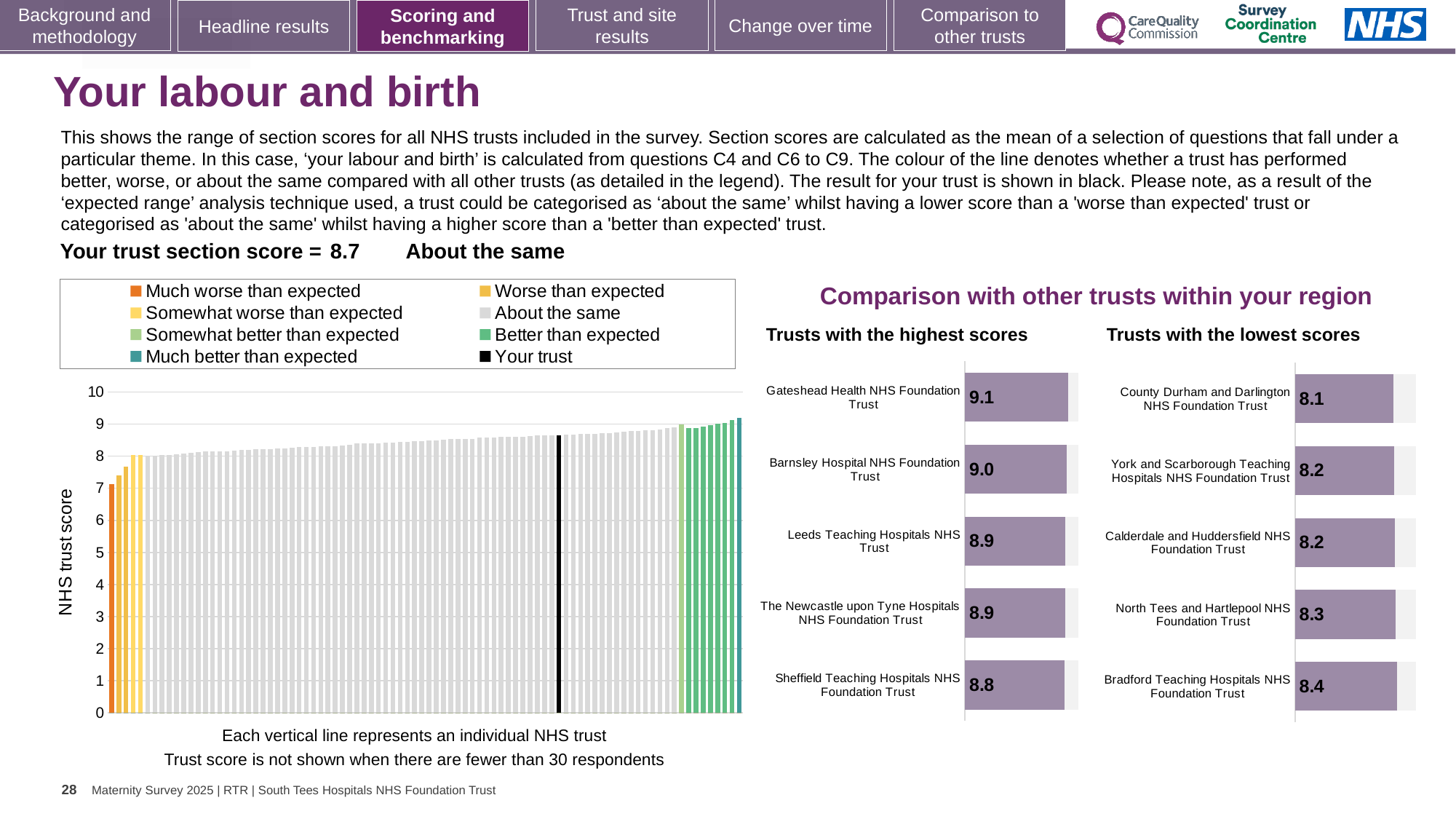
In the left-hand chart, is the value for the lowest (leftmost orange) bar greater or less than 8? less In the left-hand chart, is the value for the black 'Your trust' bar greater or less than 8? greater In the 'Trusts with the lowest scores' chart, which has the larger score: Bradford Teaching Hospitals NHS Foundation Trust or County Durham and Darlington NHS Foundation Trust? Bradford Teaching Hospitals NHS Foundation Trust In the 'Trusts with the highest scores' chart, what is the difference between the scores of Gateshead Health NHS Foundation Trust and Sheffield Teaching Hospitals NHS Foundation Trust? 0.3 What is the label on the vertical axis of the left-hand chart? NHS trust score What kind of chart is the large chart on the left with the 'NHS trust score' axis? bar chart In the 'Trusts with the lowest scores' chart, what is the score for North Tees and Hartlepool NHS Foundation Trust? 8.3 In the 'Trusts with the highest scores' chart, how many trusts are shown? 5 In the 'Trusts with the highest scores' chart, which trust has the highest score? Gateshead Health NHS Foundation Trust How many entries does the legend above the left-hand chart list? 8 In the 'Trusts with the highest scores' chart, what is the score for Gateshead Health NHS Foundation Trust? 9.1 In the 'Trusts with the lowest scores' chart, which trust has the lowest score? County Durham and Darlington NHS Foundation Trust